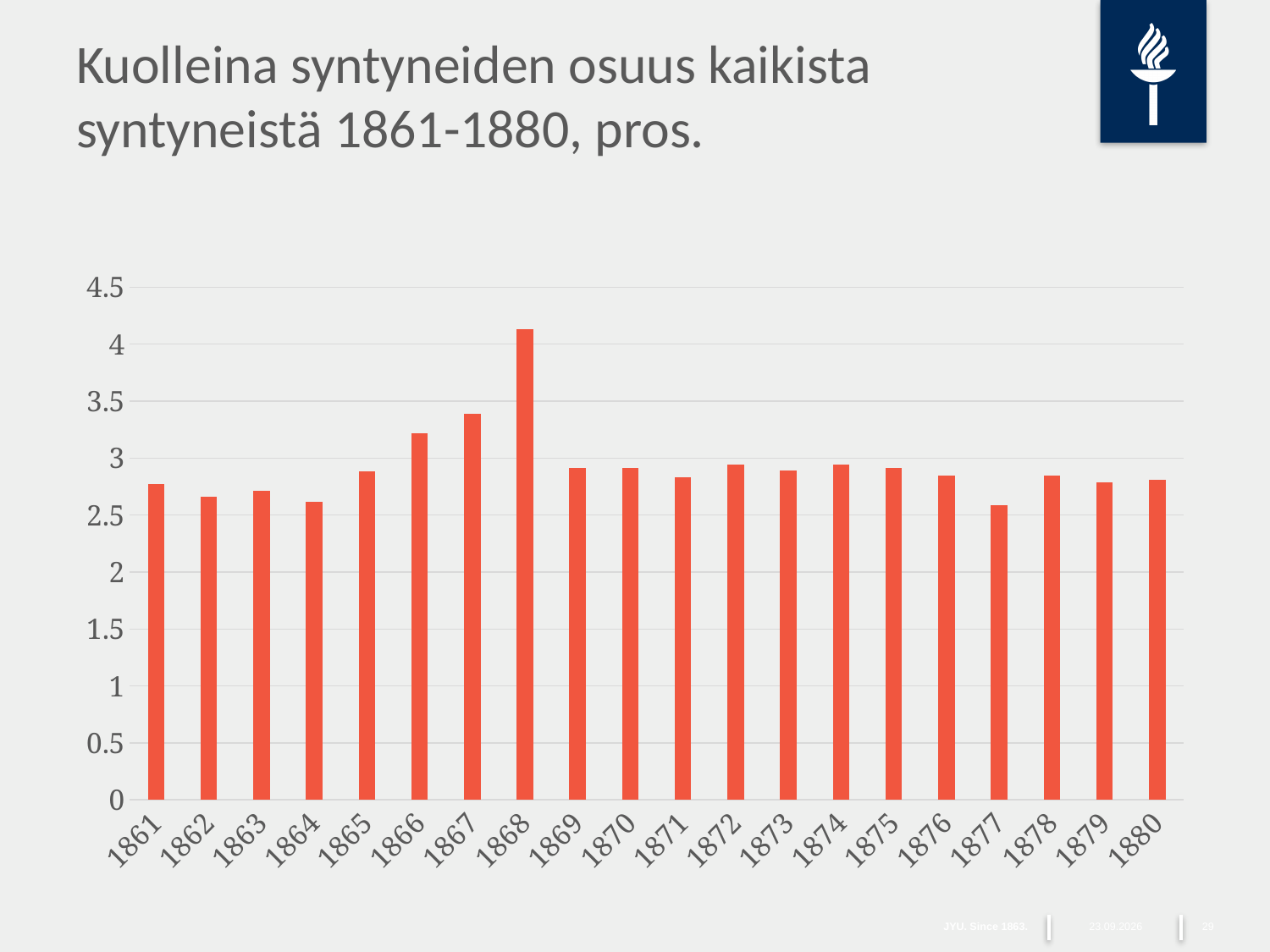
How many years are plotted on the x axis of the chart? 20 Which is larger, the value for 1867 or the value for 1866? 1867 Is the value for 1868 greater or less than 4? greater Which year has the highest share of stillbirths in the chart? 1868 Is the value for 1866 greater or less than 3? greater Is the value for 1877 greater or less than 2.5? greater What kind of chart is shown on the slide? bar chart What is the title of the chart on the slide? Kuolleina syntyneiden osuus kaikista syntyneistä 1861-1880, pros. Which is larger, the value for 1868 or the value for 1869? 1868 Do the values rise or fall from 1864 to 1868? rise